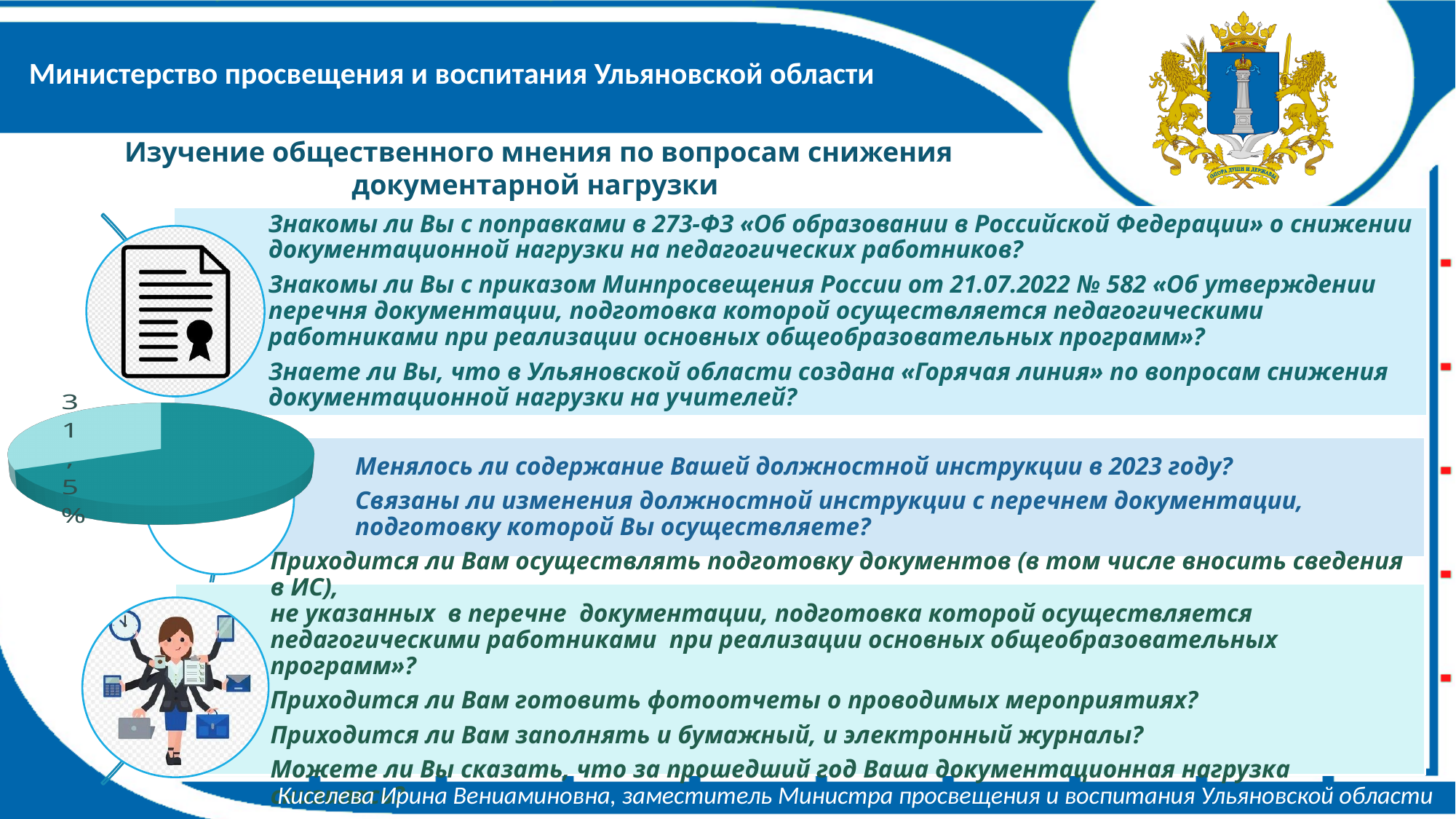
Is the pie chart drawn in 3D or flat 2D? 3D How many slices are visible in the pie chart? 2 Which slice of the pie chart is larger, the light teal slice or the dark teal slice? the dark teal slice What value is printed as a data label on the pie chart? 31,5% What kind of chart is shown on the left side of the slide? pie chart Is the slice labelled 31,5% the larger or the smaller slice of the pie chart? the smaller slice